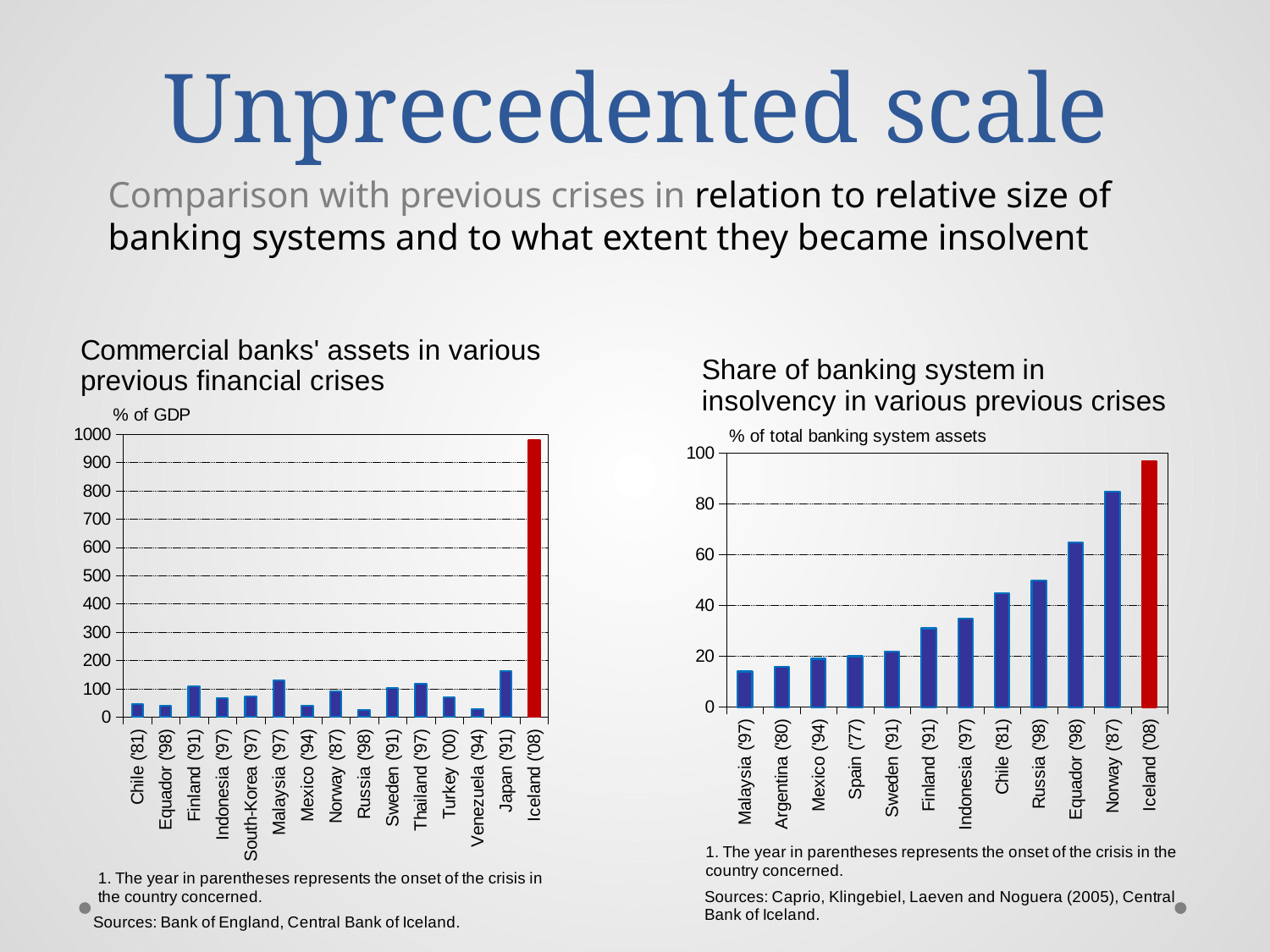
What unit is shown on the y axis of the left chart, 'Commercial banks' assets in various previous financial crises'? % of GDP How many countries are shown in the left chart, 'Commercial banks' assets in various previous financial crises'? 15 In the left chart, 'Commercial banks' assets in various previous financial crises', is the value for Japan ('91) greater or less than 100? greater In the right chart, 'Share of banking system in insolvency in various previous crises', do the values rise or fall from left to right along the x axis? rise What kind of chart is the left chart, 'Commercial banks' assets in various previous financial crises'? bar chart In the right chart, 'Share of banking system in insolvency in various previous crises', which is larger: Equador ('98) or Chile ('81)? Equador ('98) How many countries are shown in the right chart, 'Share of banking system in insolvency in various previous crises'? 12 In the right chart, 'Share of banking system in insolvency in various previous crises', which country has the highest value? Iceland ('08) In the left chart, 'Commercial banks' assets in various previous financial crises', which country has the highest value? Iceland ('08) In the left chart, 'Commercial banks' assets in various previous financial crises', which is larger: Malaysia ('97) or Russia ('98)? Malaysia ('97) In the left chart, 'Commercial banks' assets in various previous financial crises', is the value for Iceland ('08) greater or less than 900? greater In the right chart, 'Share of banking system in insolvency in various previous crises', is the value for Norway ('87) greater or less than 80? greater